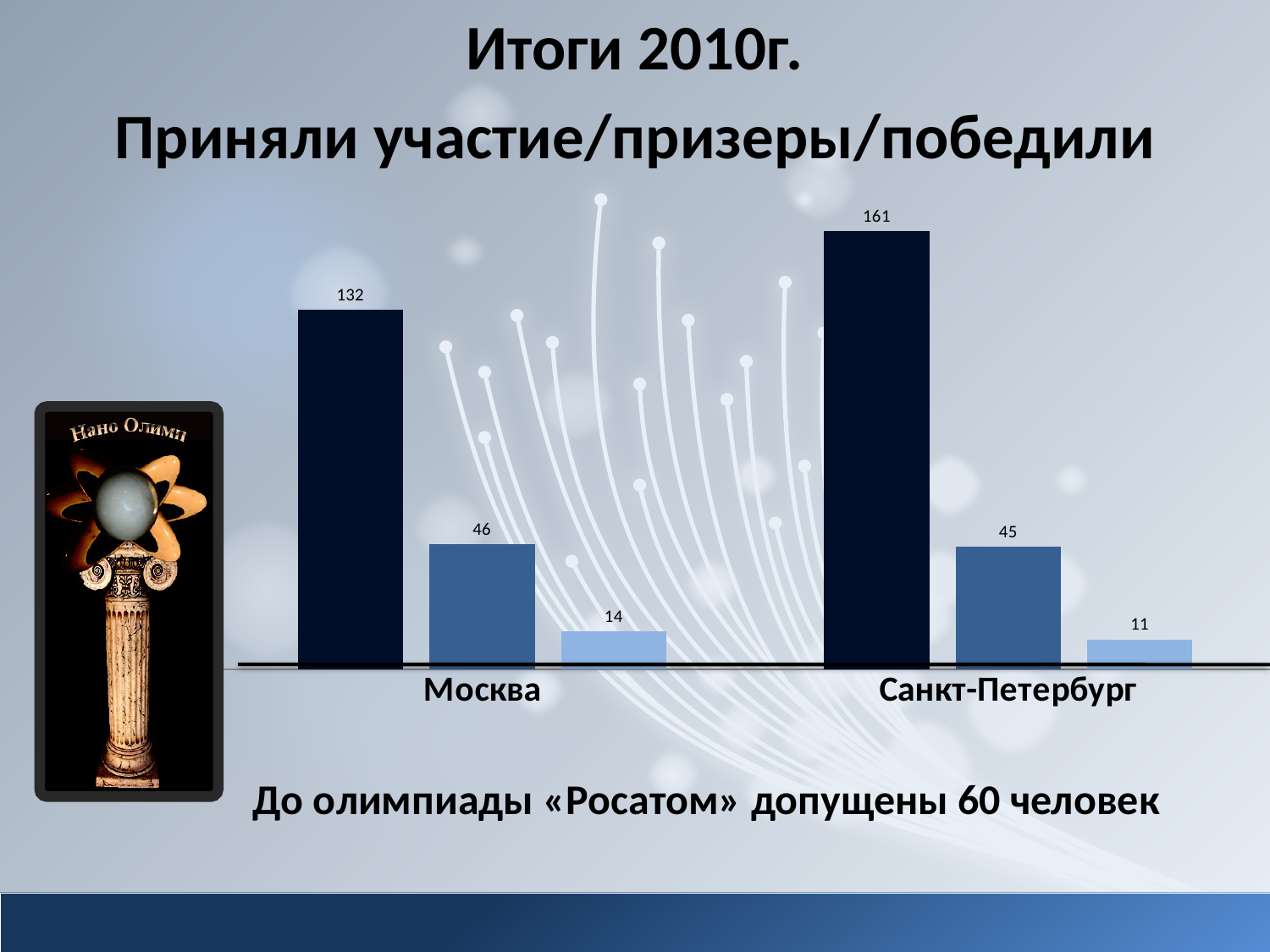
What type of chart is shown on the slide? bar chart What is the value of the third (light blue) bar for Санкт-Петербург? 11 What is the difference between the second bar for Москва (46) and the second bar for Санкт-Петербург (45)? 1 Which category has the highest single bar value in the chart? Санкт-Петербург Which is larger: the third bar for Москва or the third bar for Санкт-Петербург? Москва (14) What is the value of the second (medium blue) bar for Москва? 46 What is the value of the tallest (first) bar for Санкт-Петербург? 161 Which bar has the lowest value in the chart? the third bar for Санкт-Петербург (11) What is the value of the tallest (first) bar for Москва? 132 How many categories are shown on the x axis of the chart? 2 What is the difference between the first bar for Санкт-Петербург (161) and the first bar for Москва (132)? 29 What is the title of the chart on the slide? Итоги 2010г. Приняли участие/призеры/победили